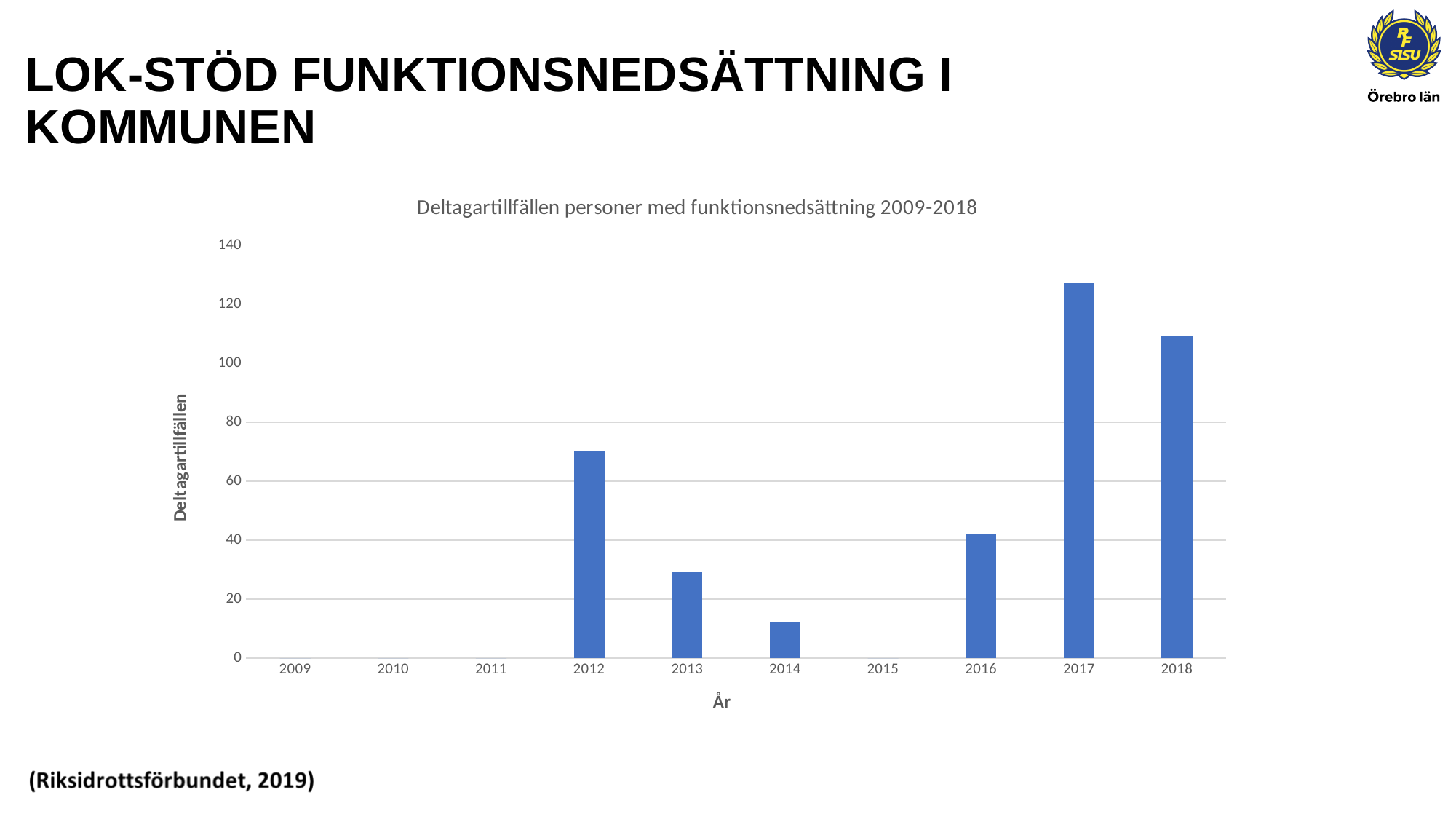
How many years are shown on the x axis of the chart? 10 Which year has the highest number of Deltagartillfällen? 2017 Which is larger, the value for 2012 or the value for 2013? 2012 Does the value rise or fall from 2017 to 2018? fall Is the value for 2018 greater or less than 100? greater What is the title of the chart? Deltagartillfällen personer med funktionsnedsättning 2009-2018 Is the value for 2014 greater or less than 20? less What kind of chart is shown on the slide? bar chart Among the years with a visible bar, which year has the lowest value? 2014 Is the value for 2017 greater or less than 120? greater